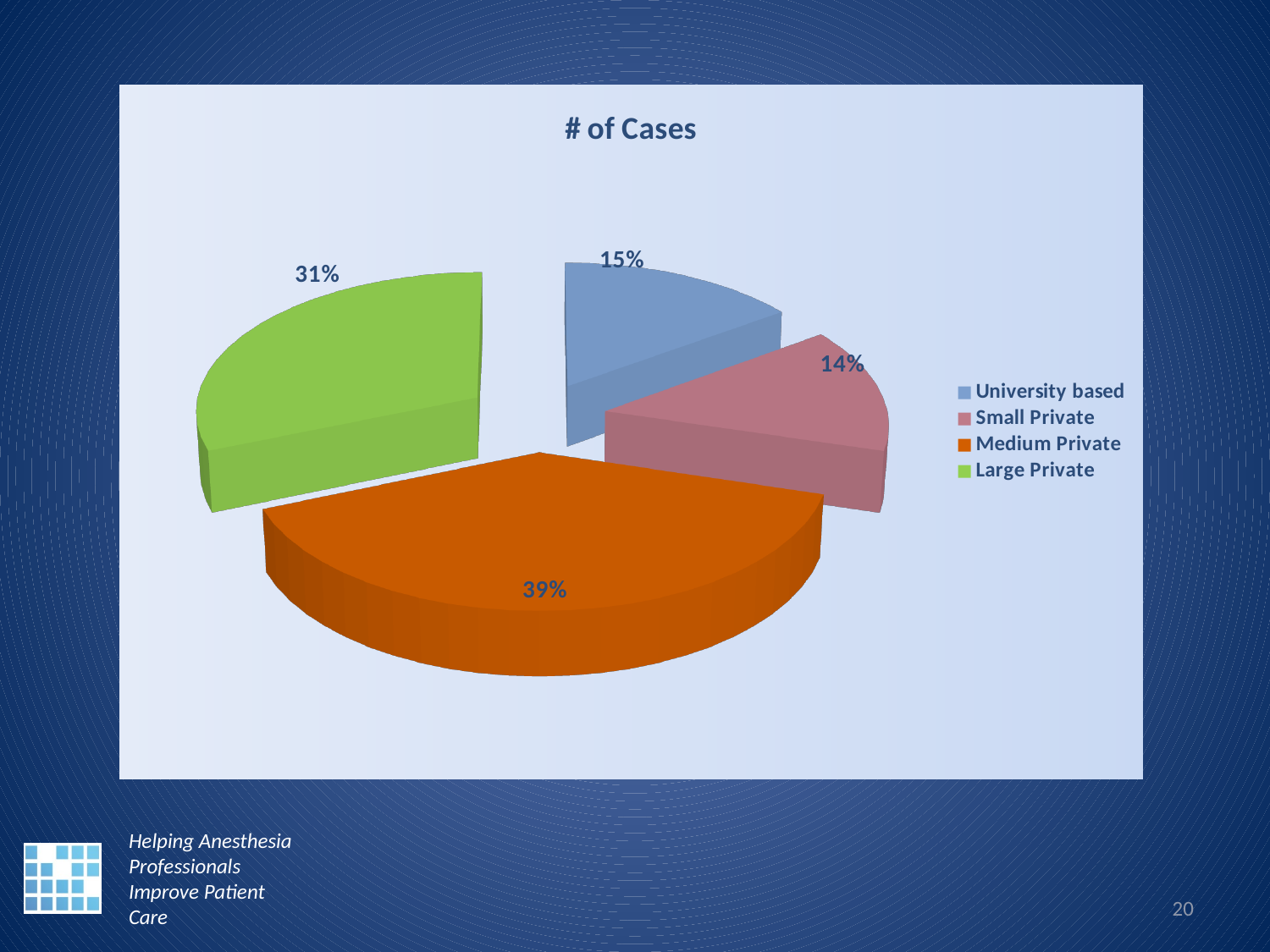
Which is larger, the share for University based or the share for Large Private? Large Private What is the title of the chart? # of Cases What share of cases is University based? 15% How many categories does the pie chart show? 4 What kind of chart is shown on the slide? Pie chart What share of cases is Medium Private? 39% Which category has the smallest share of cases? Small Private What share of cases is Small Private? 14% Which category has the largest share of cases? Medium Private What is the difference in percentage points between Medium Private and Large Private? 8 What colour is the Medium Private slice? Orange